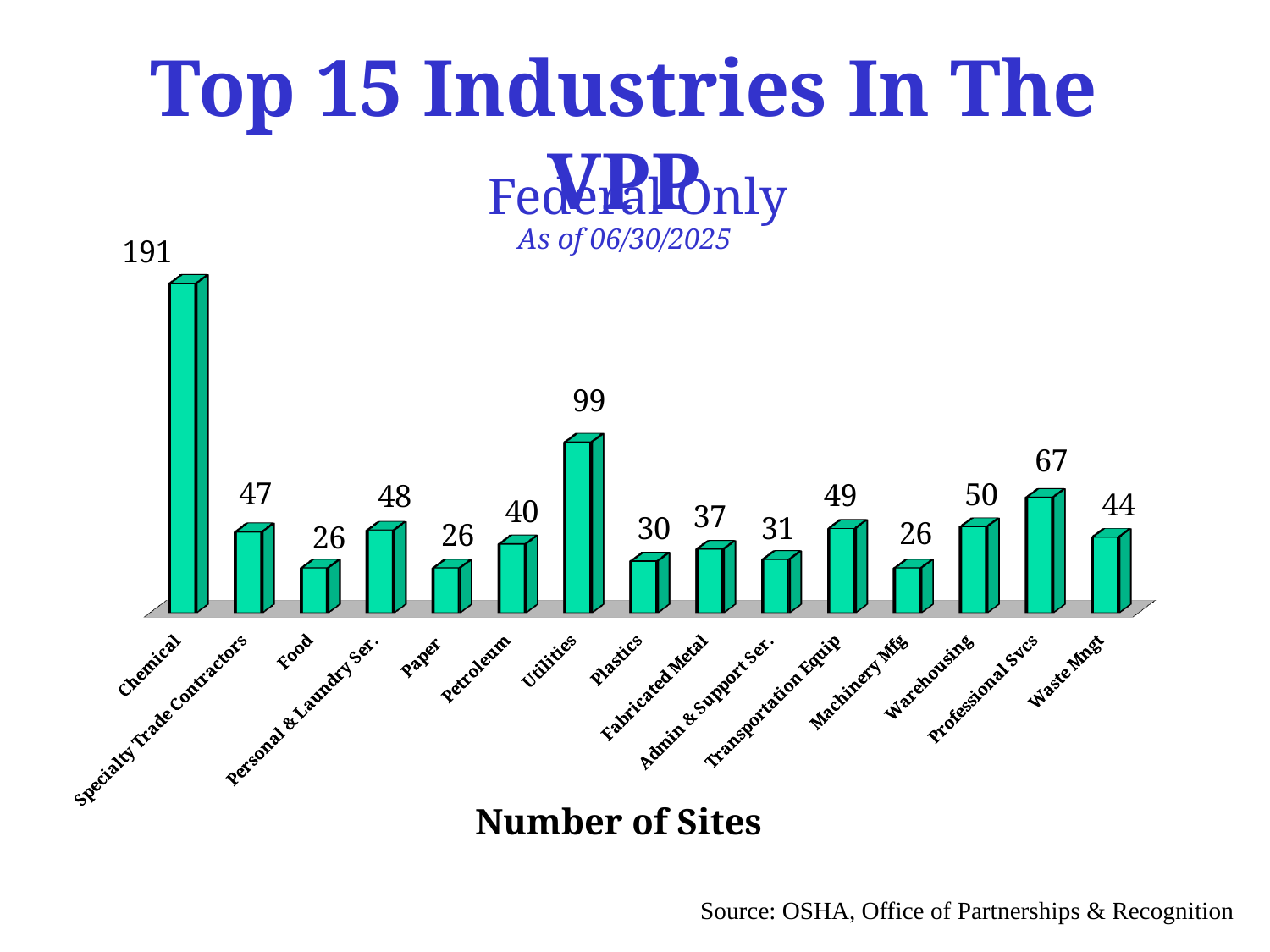
Which has more sites, Transportation Equip or Fabricated Metal? Transportation Equip What is the label on the horizontal axis of the chart? Number of Sites What is the value for Warehousing? 50 Which industry has the highest number of sites? Chemical What is the number of sites for Utilities? 99 Which has more sites, Petroleum or Personal & Laundry Ser.? Personal & Laundry Ser. What is the difference in number of sites between Chemical and Utilities? 92 How many sites are shown for Professional Svcs? 67 How many sites does the Chemical industry have? 191 What is the difference between Professional Svcs and Waste Mngt? 23 What type of chart is shown on the slide? Bar chart How many industries are shown in the chart? 15